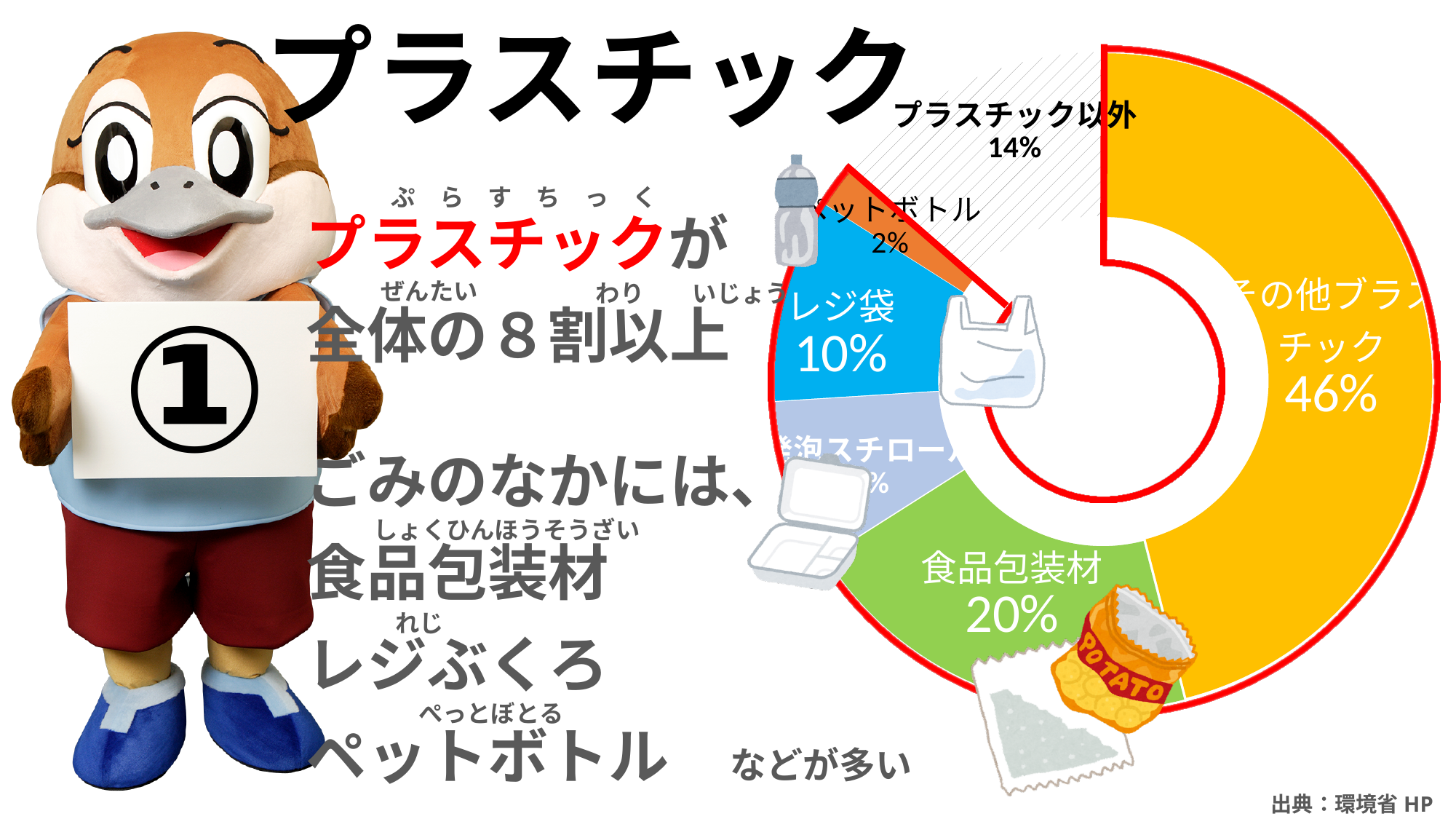
What percentage is labelled for レジ袋 in the pie chart? 10% Which category has the smallest slice in the pie chart? ペットボトル What percentage does the その他プラスチック slice represent in the pie chart? 46% What kind of chart is shown on the slide? Doughnut chart What is the value shown for ペットボトル in the pie chart? 2% How many percentage points larger is その他プラスチック than 食品包装材? 26 How many slices does the pie chart have? 6 What percentage is shown for プラスチック以外 in the pie chart? 14% Which category has the largest slice in the pie chart? その他プラスチック Which is larger in the pie chart, レジ袋 or ペットボトル? レジ袋 What is the value shown for 食品包装材 in the pie chart? 20% What source is cited for the chart at the bottom right of the slide? 環境省 HP